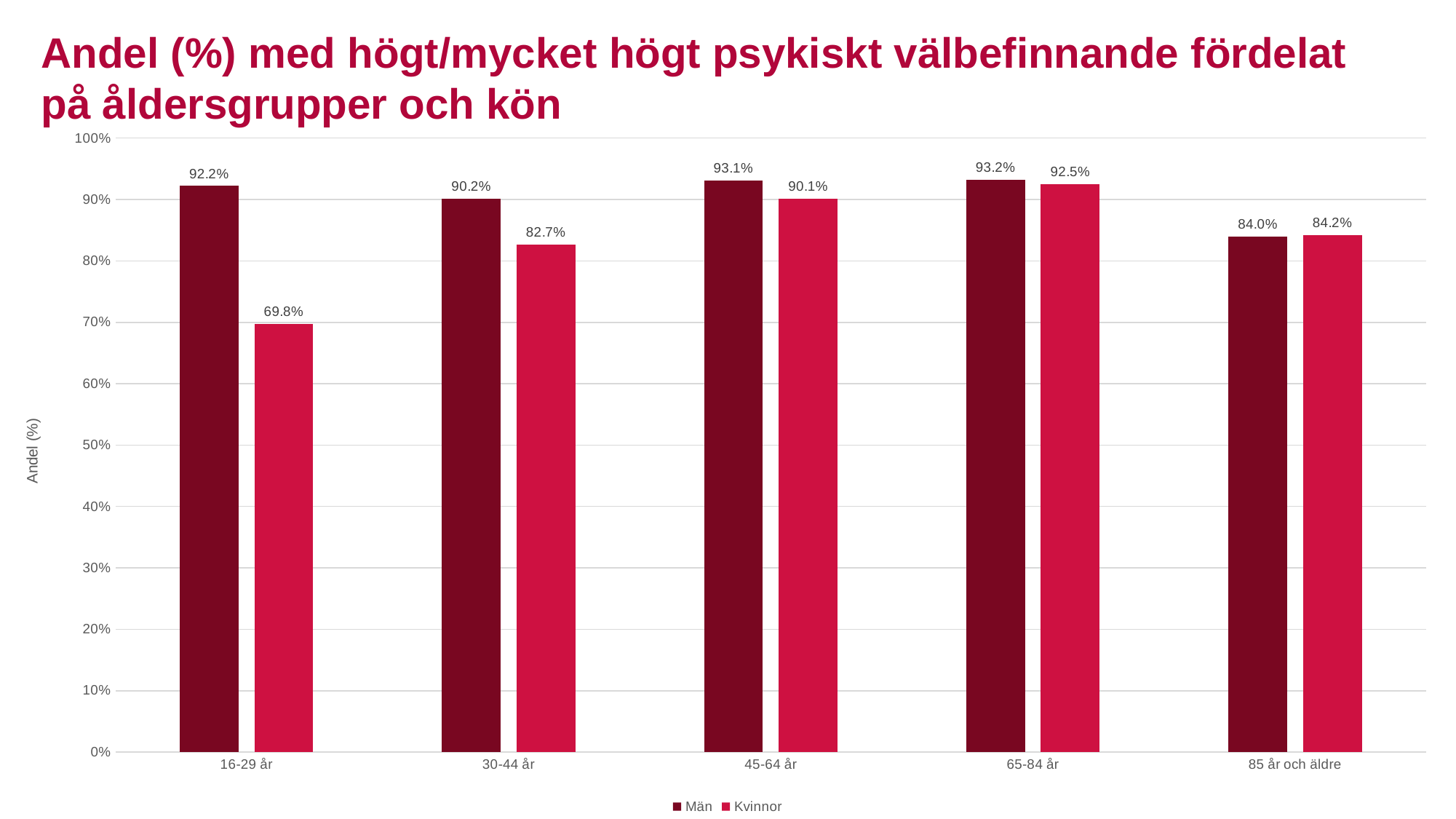
What kind of chart is shown on the slide? Bar chart Which is larger in the 30-44 år age group, Män or Kvinnor? Män Which age group has the lowest value for Kvinnor? 16-29 år What is the value for Män in the 45-64 år age group? 93.1% What is the value for Kvinnor in the 16-29 år age group? 69.8% How many series does the legend list? 2 What is the label of the y axis? Andel (%) Is the value for Kvinnor in the 30-44 år age group greater or less than 80%? greater What is the value for Kvinnor in the 85 år och äldre age group? 84.2% How many age groups are shown on the x axis? 5 What is the difference between Män and Kvinnor in the 16-29 år age group? 22.4 percentage points Which age group has the highest value for Män? 65-84 år